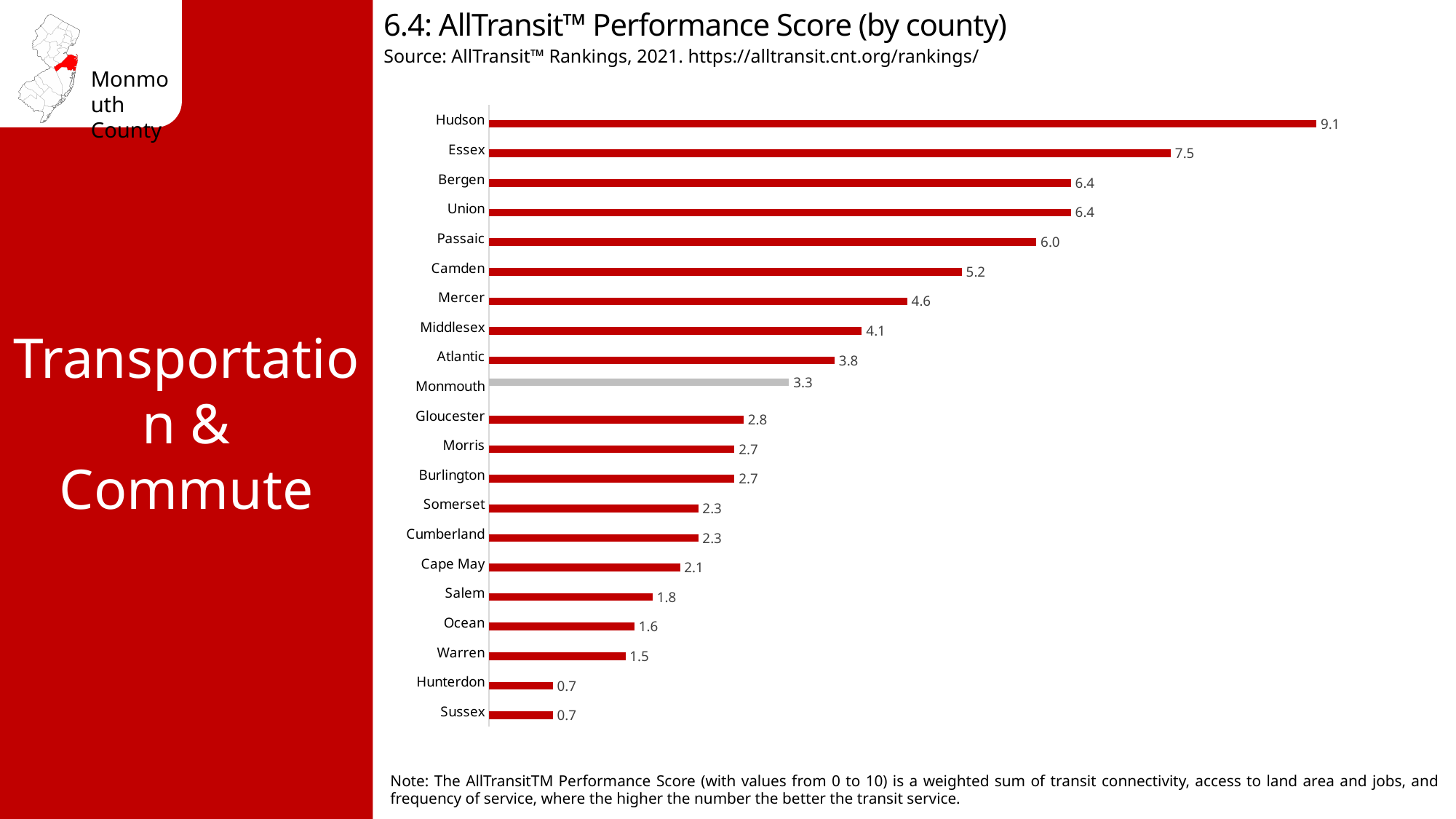
Which county has the highest AllTransit Performance Score? Hudson Which county's bar is shown in grey rather than red? Monmouth What is the difference between the AllTransit Performance Scores of Hudson and Essex? 1.6 What is the difference between the AllTransit Performance Scores of Monmouth and Ocean? 1.7 What kind of chart is used to show the AllTransit Performance Score by county? Bar chart What is the AllTransit Performance Score for Passaic County? 6.0 What is the AllTransit Performance Score for Hudson County? 9.1 How many counties are shown in the chart? 21 What is the AllTransit Performance Score for Monmouth County? 3.3 Which has a higher AllTransit Performance Score, Middlesex or Atlantic? Middlesex What is the AllTransit Performance Score for Salem County? 1.8 Which has a higher AllTransit Performance Score, Camden or Mercer? Camden